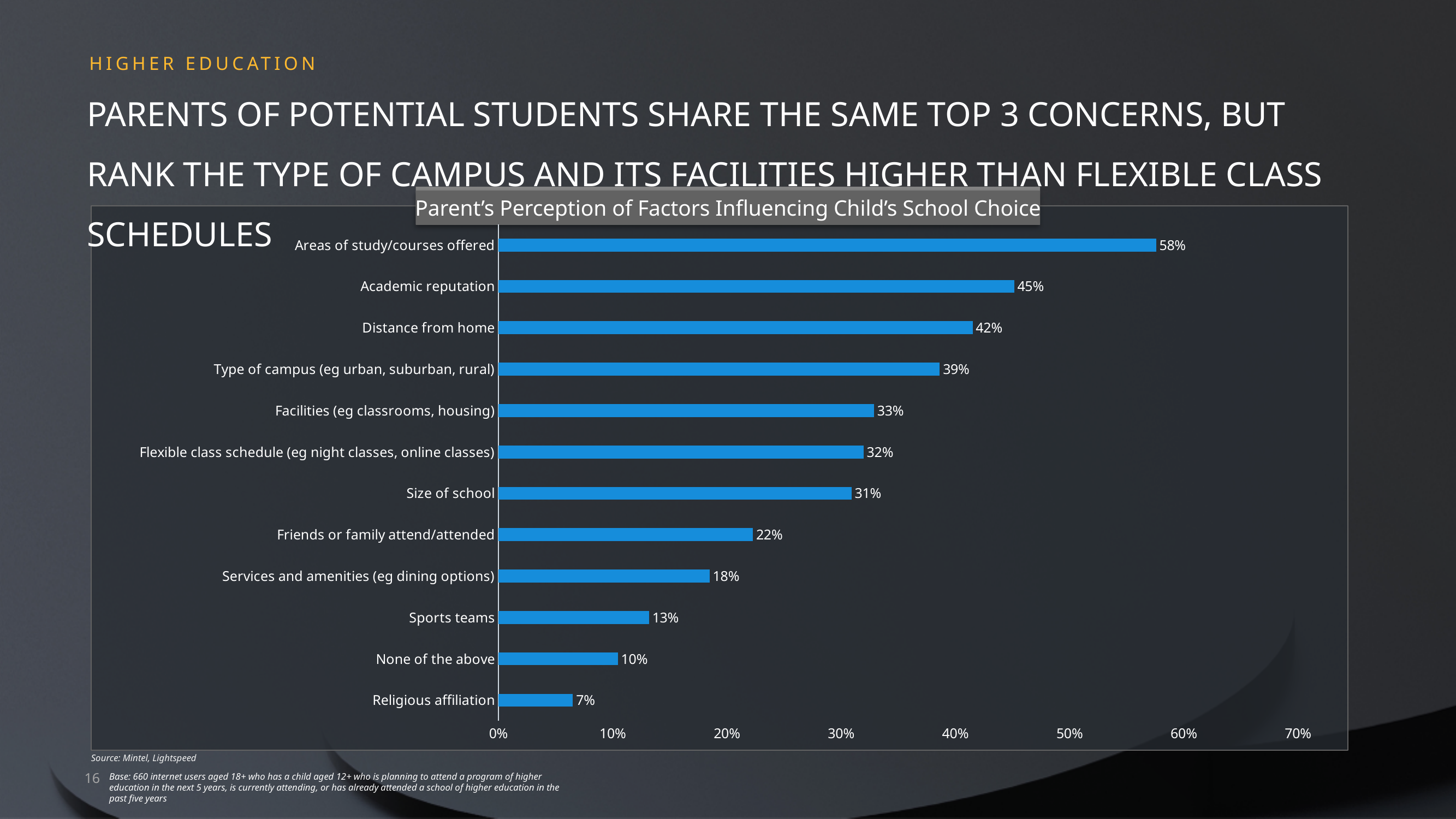
How many factors (categories) are shown in the chart? 12 What is the difference between the values for Friends or family attend/attended and Services and amenities (eg dining options)? 4% Which factor has the highest value in the chart? Areas of study/courses offered Which factor has the lowest value in the chart? Religious affiliation What is the difference between the values for Academic reputation and Distance from home? 3% What is the value for Type of campus (eg urban, suburban, rural)? 39% What percentage of parents cited Areas of study/courses offered as a factor influencing their child's school choice? 58% Is the value for Size of school greater or less than 30%? greater What type of chart is shown on the slide? Bar chart What is the value for Sports teams? 13% What is the title of the chart? Parent's Perception of Factors Influencing Child's School Choice Which is larger, the value for Facilities (eg classrooms, housing) or the value for Flexible class schedule (eg night classes, online classes)? Facilities (eg classrooms, housing)